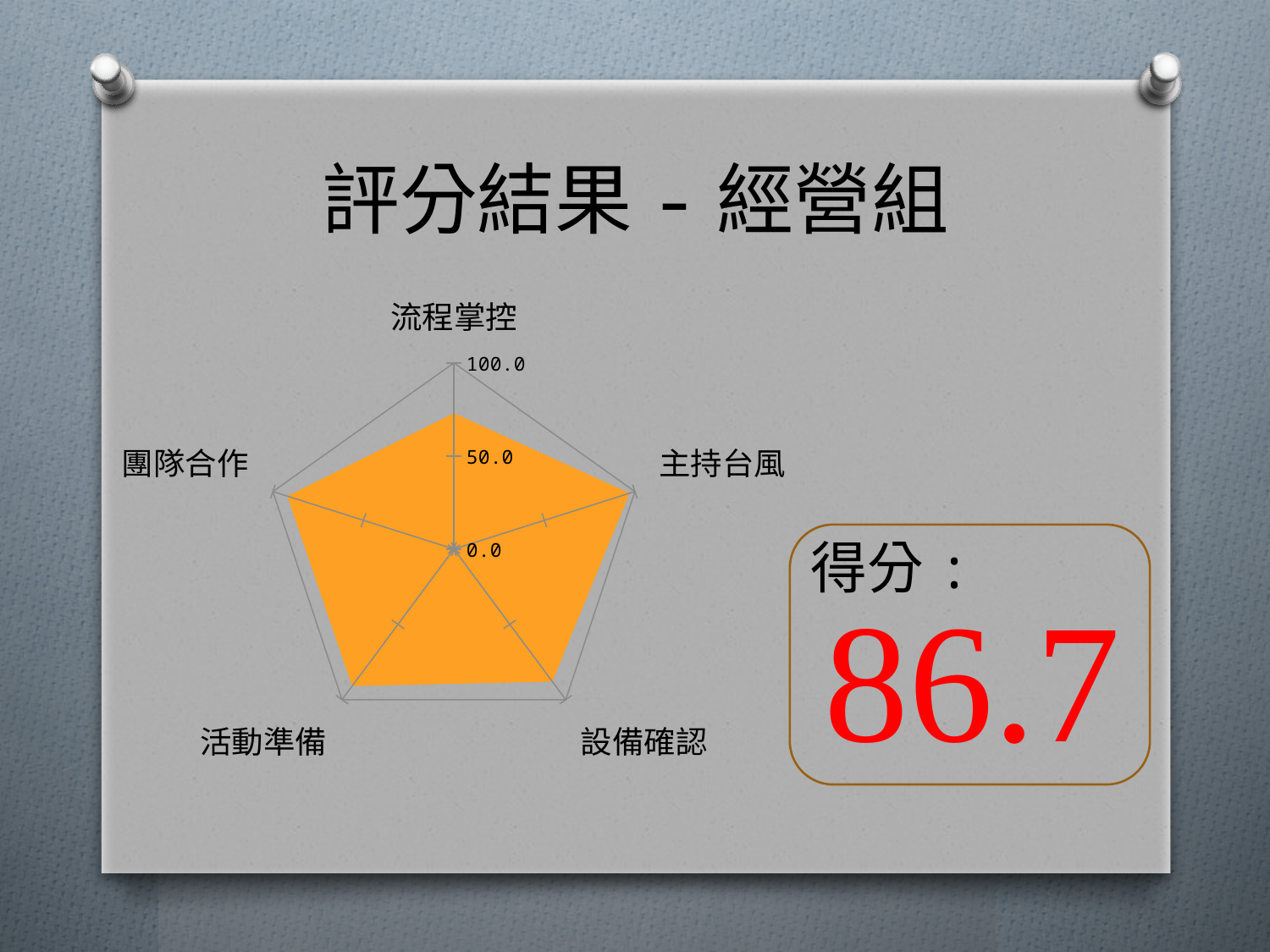
What kind of chart is shown on the slide? radar chart Which category has the lowest value on the radar chart? 流程掌控 Is the value for 流程掌控 greater or less than 50.0? greater What is the title of the slide containing the radar chart? 評分結果 - 經營組 How many categories (axes) does the radar chart have? 5 What is the maximum value shown on the radar chart's axis scale? 100.0 Is the value for 團隊合作 greater or less than 50.0? greater Which is larger, the value for 設備確認 or the value for 流程掌控? 設備確認 Which is larger, the value for 主持台風 or the value for 流程掌控? 主持台風 Is the value for 活動準備 greater or less than 50.0? greater